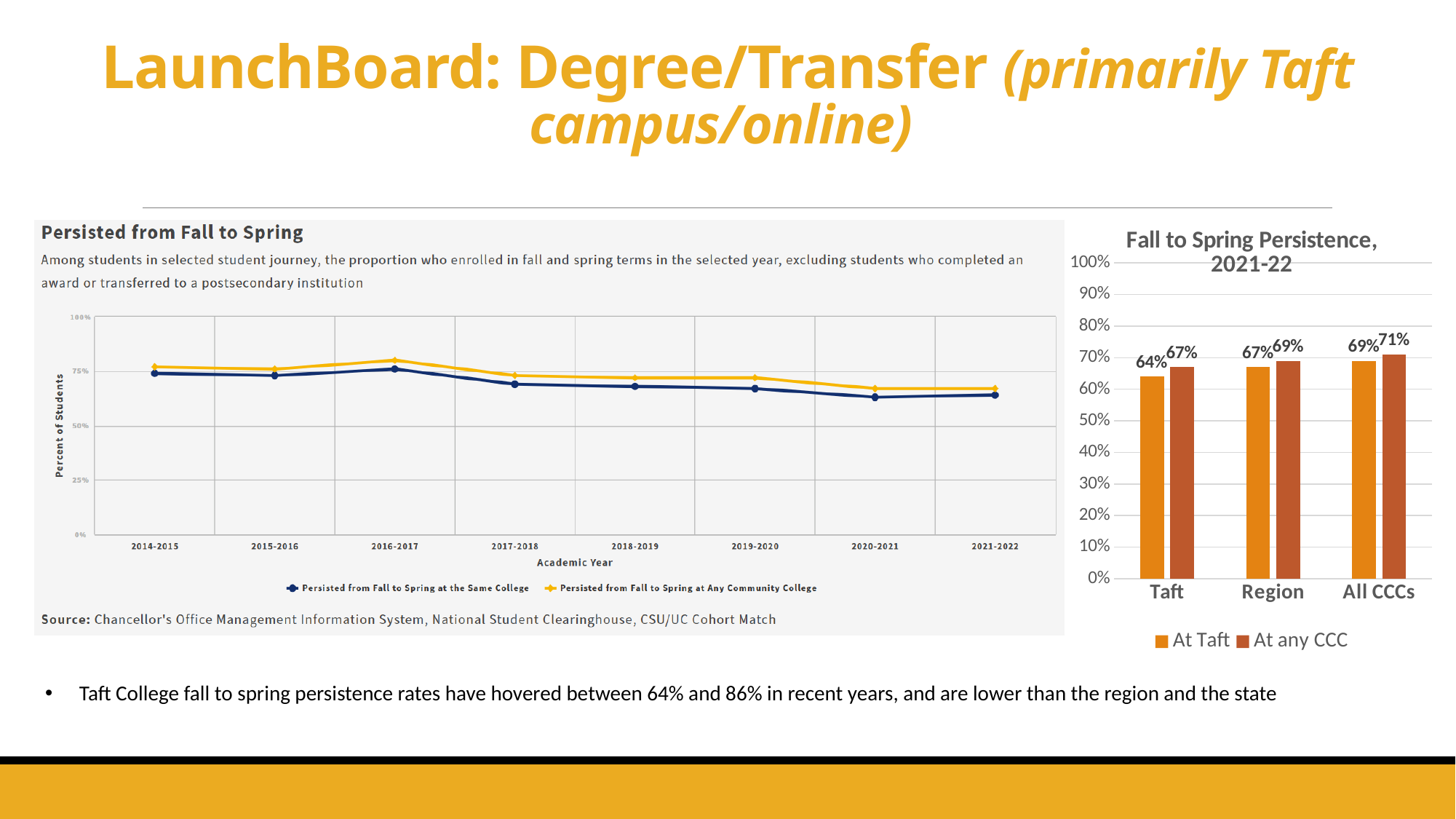
In the 'Persisted from Fall to Spring' line chart, how many academic years are shown on the x axis? 8 In the 'Fall to Spring Persistence, 2021-22' bar chart, which category has the lowest 'At Taft' value? Taft In the 'Fall to Spring Persistence, 2021-22' bar chart, what is the 'At any CCC' value for All CCCs? 71% In the 'Persisted from Fall to Spring' line chart, is the value for 'Persisted from Fall to Spring at the Same College' in 2021-2022 greater or less than 75%? less In the 'Persisted from Fall to Spring' line chart, do the values for 'Persisted from Fall to Spring at the Same College' generally rise or fall from 2016-2017 to 2021-2022? fall In the 'Fall to Spring Persistence, 2021-22' bar chart, which category has the highest 'At any CCC' value? All CCCs What kind of chart is the 'Persisted from Fall to Spring' chart on the left? Line chart In the 'Fall to Spring Persistence, 2021-22' bar chart, what is the 'At any CCC' value for Region? 69% In the 'Fall to Spring Persistence, 2021-22' bar chart, what is the difference between the 'At any CCC' and 'At Taft' values for All CCCs? 2% In the 'Fall to Spring Persistence, 2021-22' bar chart, how many categories are shown on the x axis? 3 In the 'Fall to Spring Persistence, 2021-22' bar chart, how many series does the legend list? 2 In the 'Fall to Spring Persistence, 2021-22' bar chart, what is the 'At Taft' value for Taft? 64%